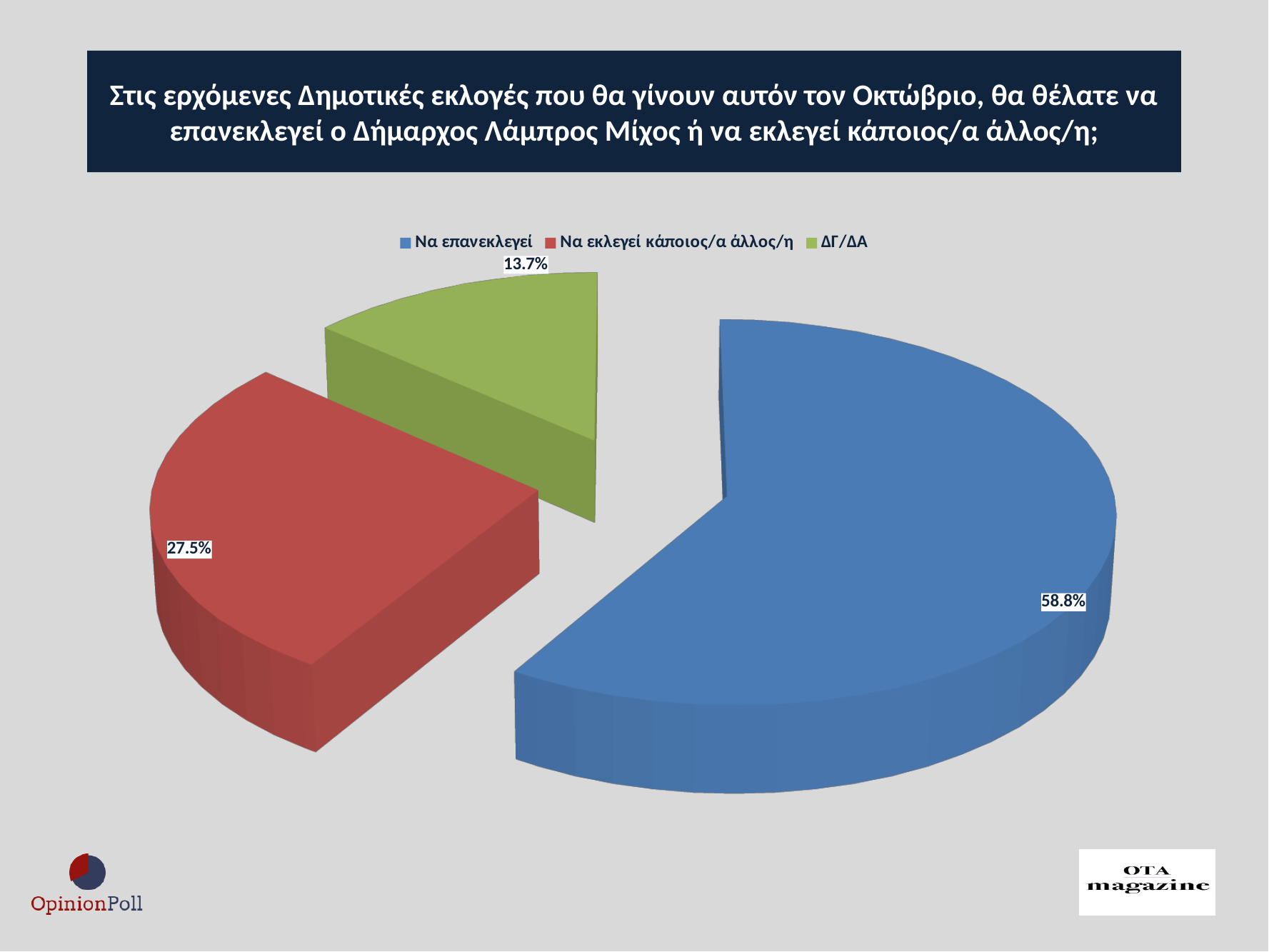
Which category is shown in blue in the legend? Να επανεκλεγεί What is the value for "Να επανεκλεγεί"? 58.8% What is the value for "Να εκλεγεί κάποιος/α άλλος/η"? 27.5% What kind of chart is shown on the slide? Pie chart Which category has the largest share of the pie? Να επανεκλεγεί What colour is the slice for "ΔΓ/ΔΑ"? Green Which category has the smallest share of the pie? ΔΓ/ΔΑ What is the difference between the values for "Να επανεκλεγεί" and "Να εκλεγεί κάποιος/α άλλος/η"? 31.3% Which is larger, the value for "Να εκλεγεί κάποιος/α άλλος/η" or the value for "ΔΓ/ΔΑ"? Να εκλεγεί κάποιος/α άλλος/η What is the value for "ΔΓ/ΔΑ"? 13.7% How many slices does the pie chart have? 3 What is the difference between the values for "Να εκλεγεί κάποιος/α άλλος/η" and "ΔΓ/ΔΑ"? 13.8%